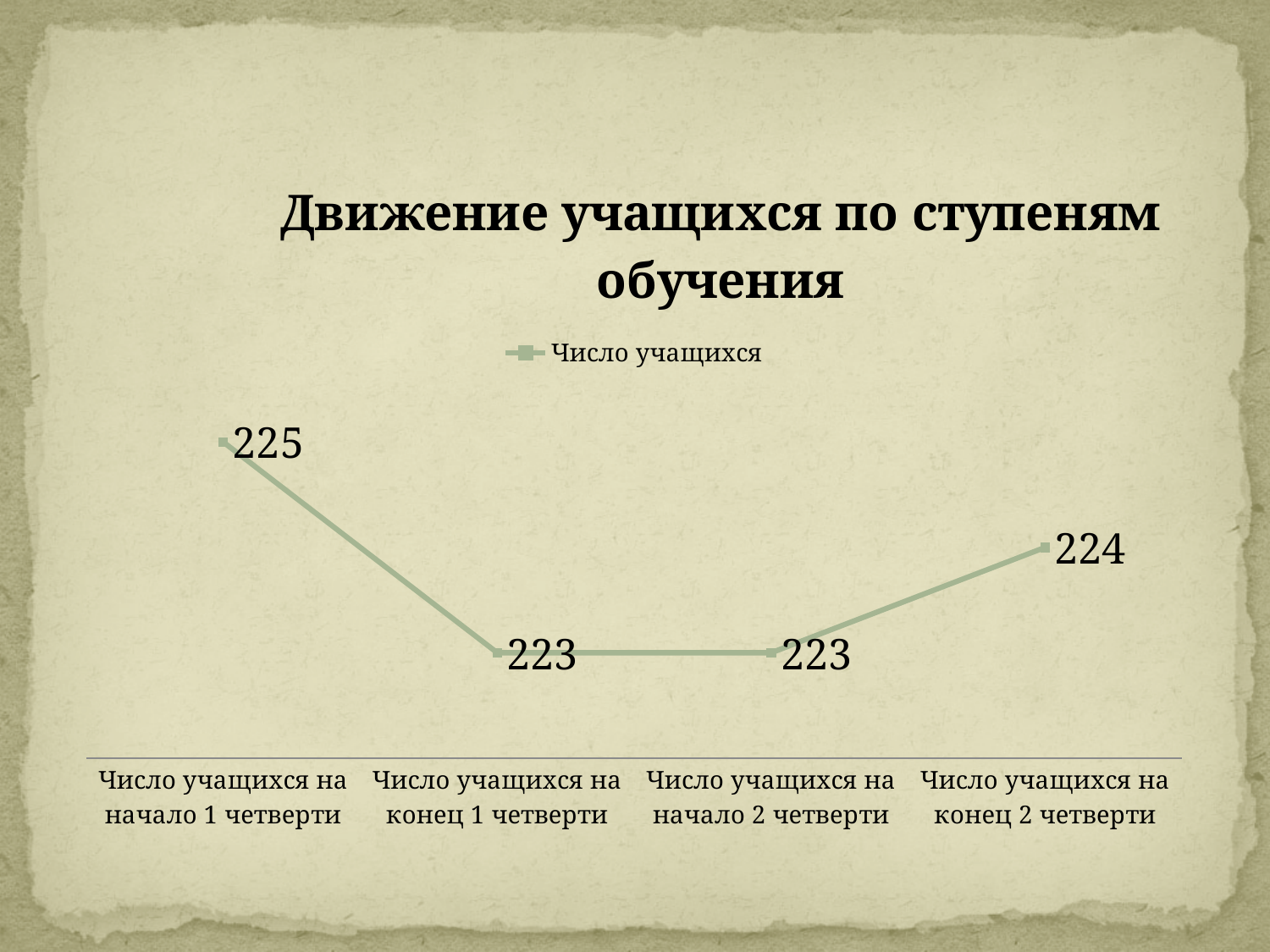
Does the number of students rise or fall from the start of the 1st quarter to the end of the 1st quarter? Fall What is the number of students at the end of the 2nd quarter (Число учащихся на конец 2 четверти)? 224 What is the difference between the number of students at the end of the 2nd quarter and at the start of the 2nd quarter? 1 What is the number of students at the end of the 1st quarter (Число учащихся на конец 1 четверти)? 223 Which is larger: the number of students at the start of the 1st quarter or at the end of the 2nd quarter? Число учащихся на начало 1 четверти What is the title of the chart? Движение учащихся по ступеням обучения What kind of chart is shown on the slide? Line chart Which category has the highest number of students? Число учащихся на начало 1 четверти How many data points are plotted on the chart? 4 How many series does the legend list? 1 What is the difference between the number of students at the start of the 1st quarter and at the end of the 1st quarter? 2 What is the number of students at the start of the 1st quarter (Число учащихся на начало 1 четверти)? 225